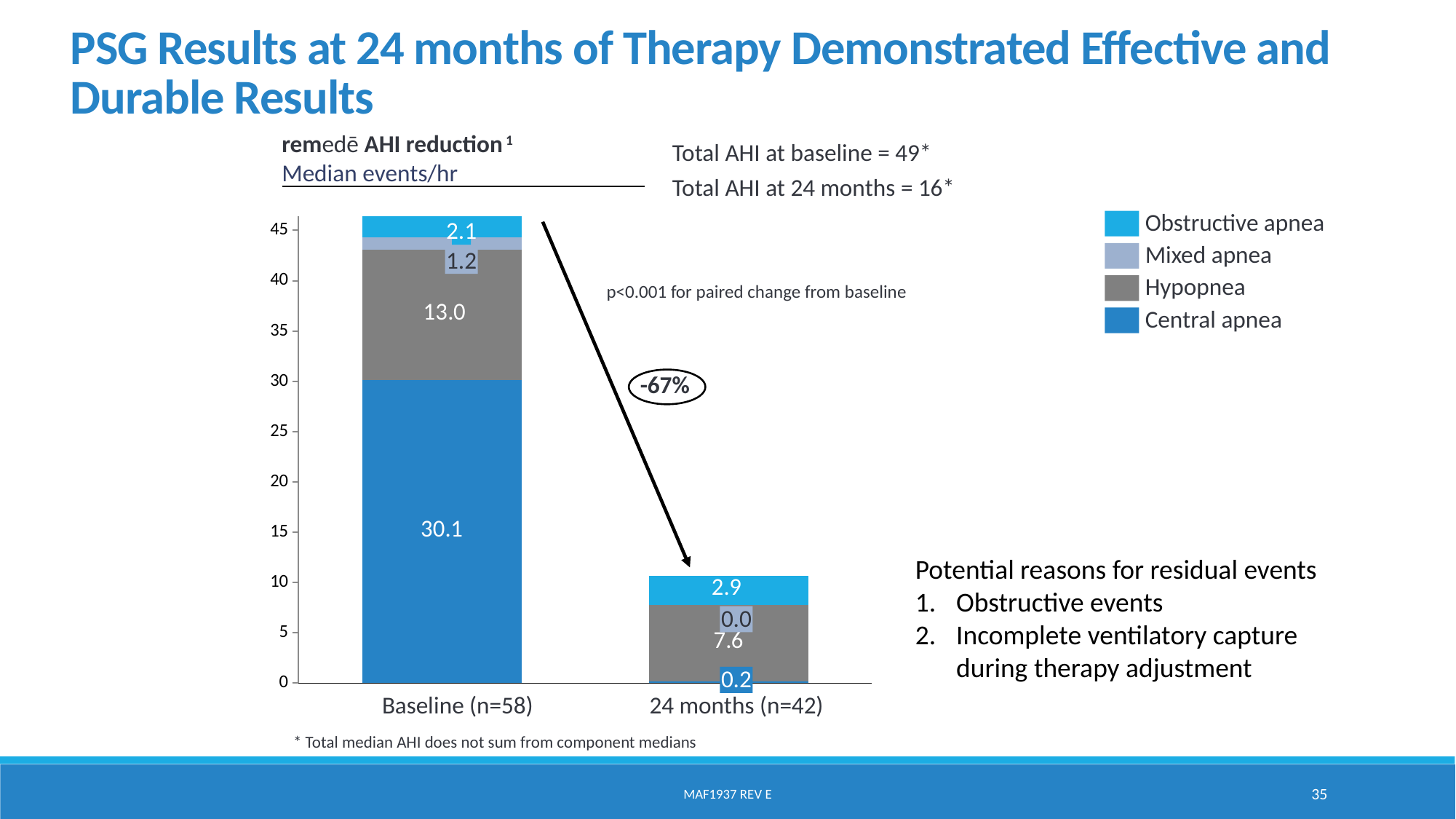
What is the Mixed apnea value at Baseline (n=58)? 1.2 What is the Hypopnea value for 24 months (n=42)? 7.6 What is the median Central apnea value at Baseline (n=58)? 30.1 What percentage change is shown in the oval between the two bars? -67% Is the total height of the 24 months (n=42) bar greater or less than 15? less Which component has the largest value in the Baseline (n=58) bar? Central apnea Is the Obstructive apnea value larger at Baseline or at 24 months? 24 months How many series does the legend list? 4 What is the Obstructive apnea value at 24 months (n=42)? 2.9 By how much did the Central apnea value decrease from Baseline to 24 months? 29.9 Which component has the smallest value in the 24 months (n=42) bar? Mixed apnea What is the difference in Hypopnea between Baseline (n=58) and 24 months (n=42)? 5.4